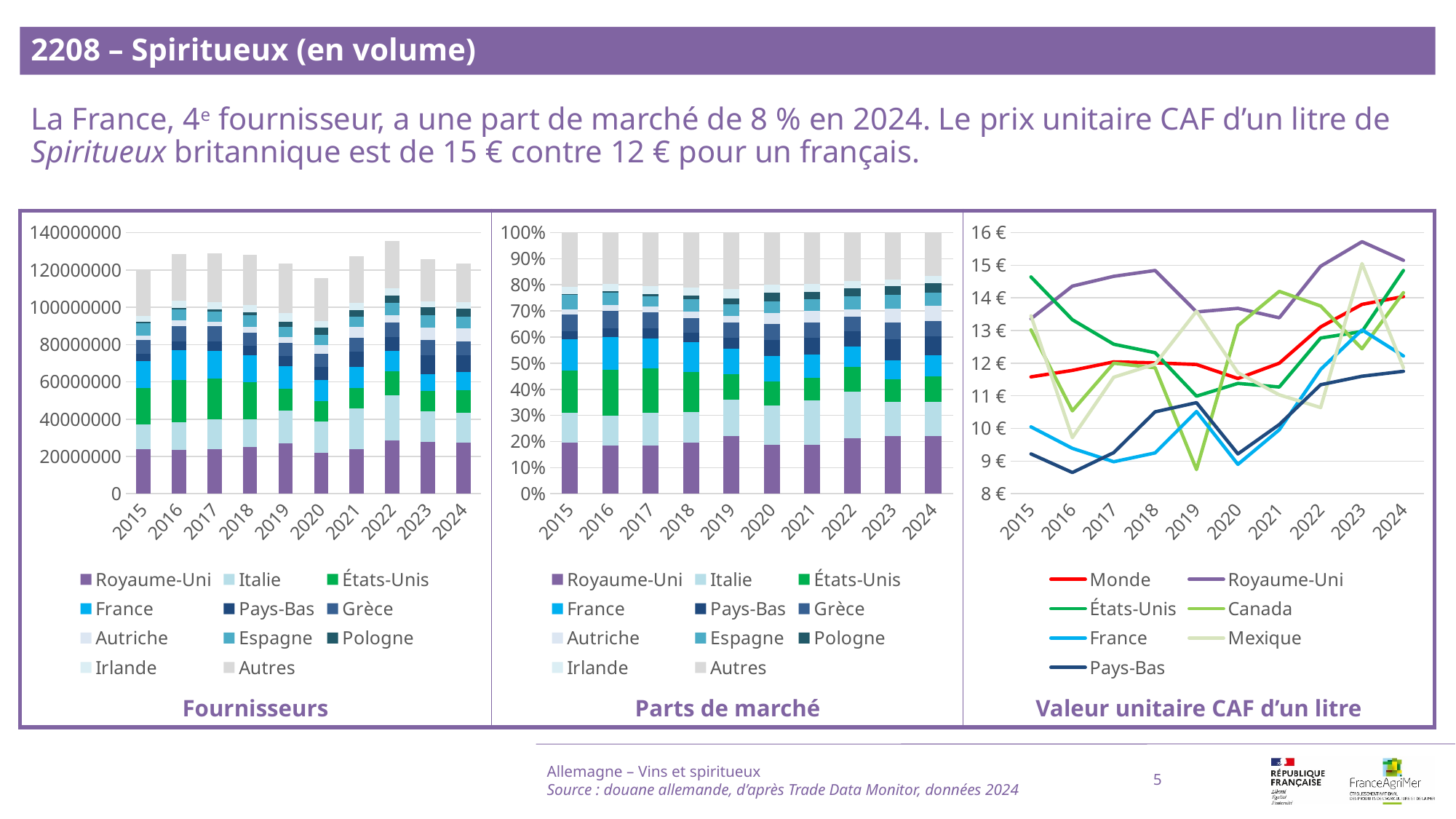
In the 'Valeur unitaire CAF d'un litre' chart, which series has the lowest value in 2019? Canada What kind of chart is the 'Fournisseurs' chart? bar chart In the 'Fournisseurs' chart, how many years are shown on the x axis? 10 How many series does the legend of the 'Parts de marché' chart list? 11 In the 'Valeur unitaire CAF d'un litre' chart, which is larger in 2024, Royaume-Uni or France? Royaume-Uni In the 'Parts de marché' chart, is the Royaume-Uni share in 2024 greater or less than 20%? greater In the 'Valeur unitaire CAF d'un litre' chart, is the value for Royaume-Uni in 2023 greater or less than 15 €? greater In the 'Valeur unitaire CAF d'un litre' chart, does the Monde series overall rise or fall from 2015 to 2024? rise In the 'Fournisseurs' chart, is the total stacked bar for 2022 greater or less than 130000000? greater How many series does the legend of the 'Valeur unitaire CAF d'un litre' chart list? 7 What kind of chart is the 'Valeur unitaire CAF d'un litre' chart? line chart